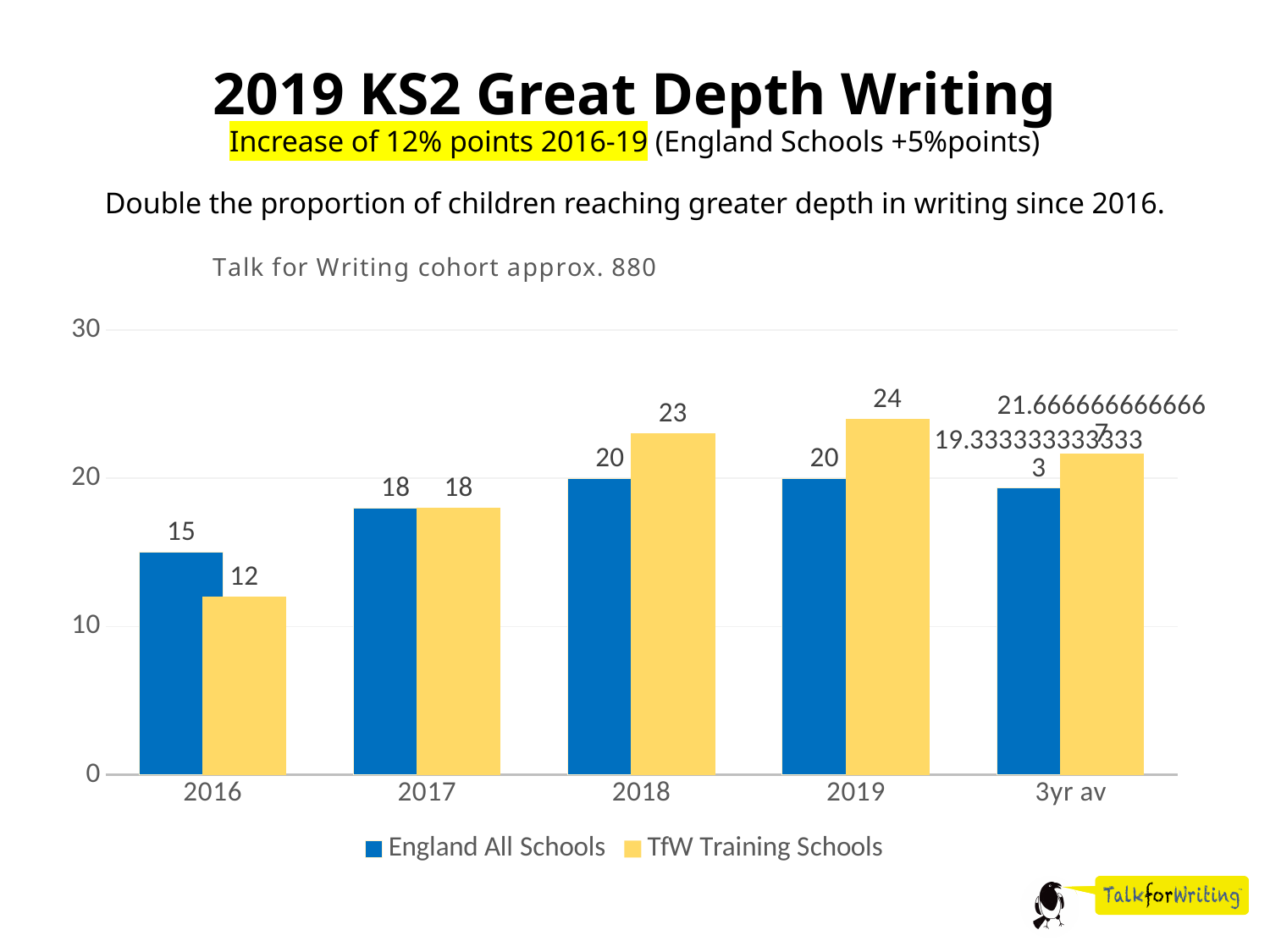
In 2018, which series has the larger value, England All Schools or TfW Training Schools? TfW Training Schools What is the value for TfW Training Schools in 2016? 12 What is the value for England All Schools in 2016? 15 What kind of chart is shown on the slide? bar chart In which year is the England All Schools value lowest? 2016 What is the difference between the TfW Training Schools value in 2019 and in 2016? 12 How many categories are shown on the x axis? 5 What is the value for TfW Training Schools in 2019? 24 In which year is the TfW Training Schools value highest? 2019 What is the value for TfW Training Schools in 2018? 23 Is the TfW Training Schools value for 3yr av greater or less than 20? greater How many series does the legend list? 2